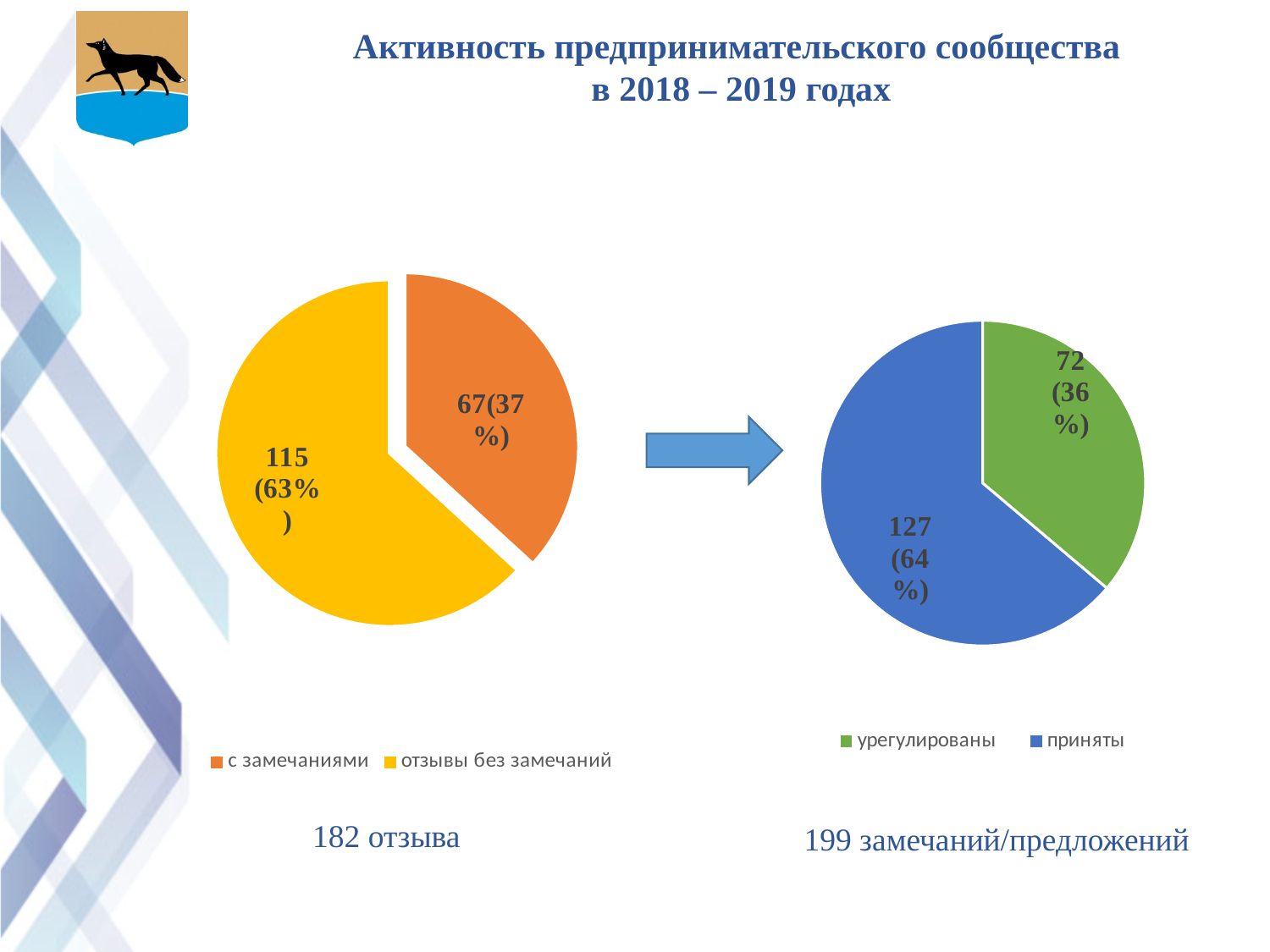
How many slices does the left pie chart have? 2 In the right pie chart, how many items are labelled 'урегулированы'? 72 In the right pie chart, what is the difference between 'приняты' and 'урегулированы'? 55 In the left pie chart, what share of the pie is 'отзывы без замечаний'? 63% What kind of chart is the left chart on the slide? pie chart In the right pie chart, which slice is the largest? приняты In the right pie chart, what share of the pie is 'приняты'? 64% In the left pie chart, how many reviews are labelled 'с замечаниями'? 67 In the left pie chart, which slice is larger: 'с замечаниями' or 'отзывы без замечаний'? отзывы без замечаний What colour is the 'урегулированы' slice in the right pie chart? green In the left pie chart, what is the difference between 'отзывы без замечаний' and 'с замечаниями'? 48 In the left pie chart, how many reviews are labelled 'отзывы без замечаний'? 115